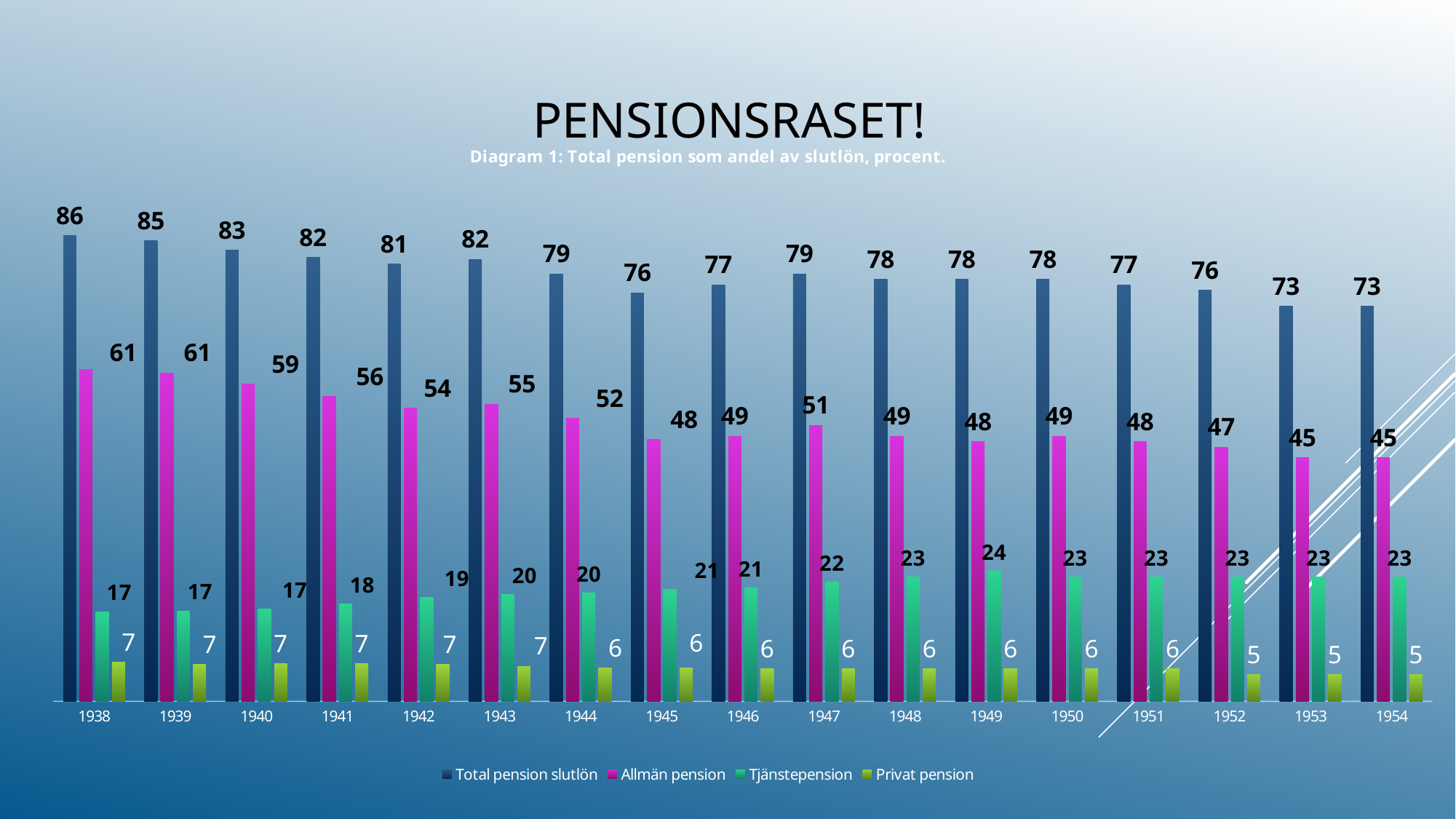
Which year has the highest value for Total pension slutlön? 1938 What is the value of Tjänstepension for 1949? 24 Does Total pension slutlön generally rise or fall from 1938 to 1954? Fall What kind of chart is shown on the slide? Bar chart Which is larger: Allmän pension in 1940 or Allmän pension in 1945? 1940 How many series does the legend list? 4 Which year has the lowest value for Allmän pension? 1953 and 1954 How many years are shown on the x axis? 17 What is the value of Privat pension for 1952? 5 What is the value of Allmän pension for 1954? 45 What is the difference between Total pension slutlön in 1938 and in 1954? 13 What is the value of Total pension slutlön for 1938? 86